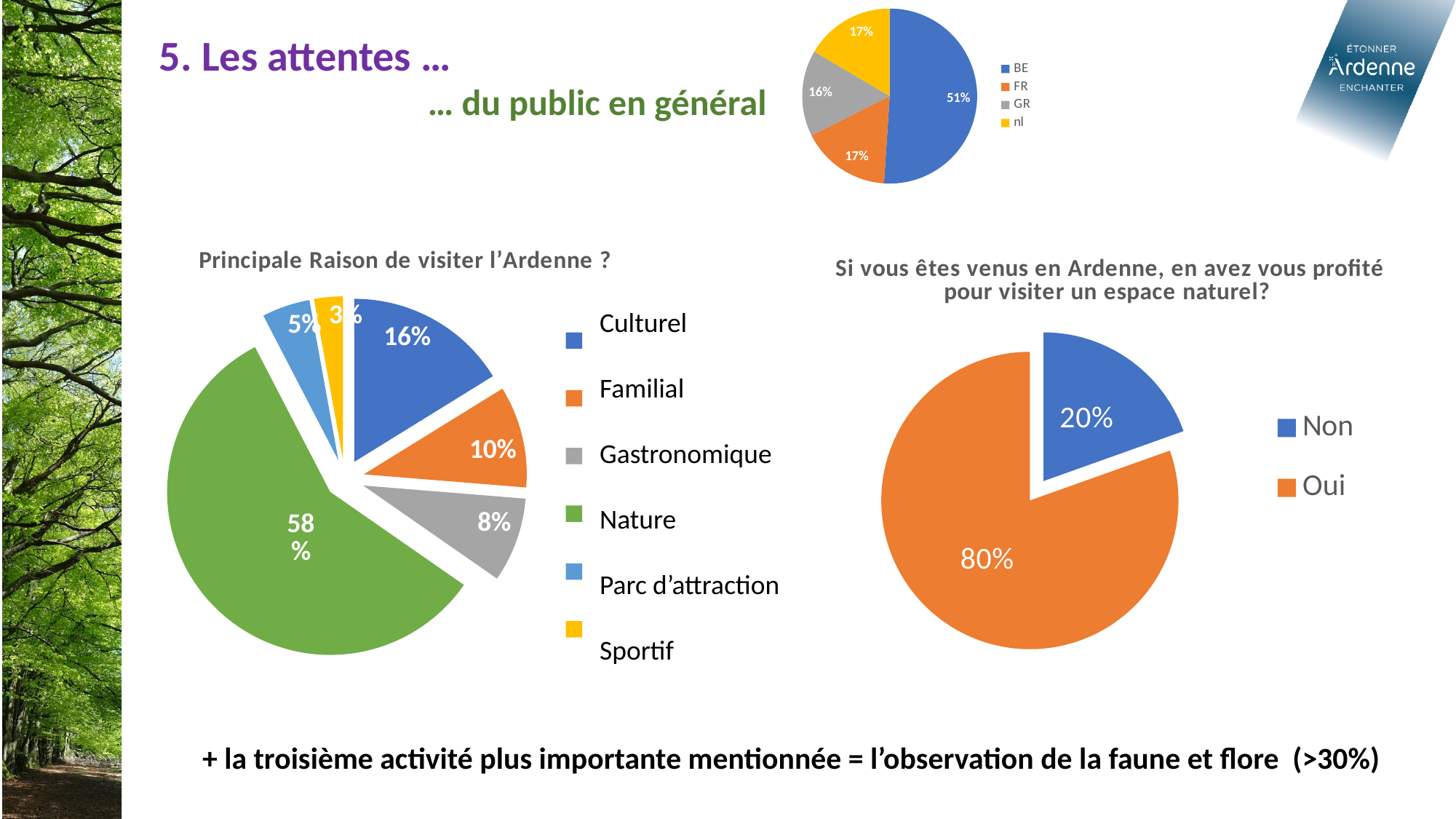
In the pie chart titled "Principale Raison de visiter l'Ardenne ?", which category has the largest slice? Nature How many categories does the legend of the small pie chart at the top of the slide list? 4 In the small pie chart at the top of the slide, what share is labelled for BE? 51% In the pie chart titled "Principale Raison de visiter l'Ardenne ?", what is the difference in percentage points between Familial and Gastronomique? 2 How many categories does the legend of the pie chart titled "Principale Raison de visiter l'Ardenne ?" list? 6 In the small pie chart at the top of the slide, what share is labelled for GR? 16% In the pie chart titled "Principale Raison de visiter l'Ardenne ?", what share is labelled for Nature? 58% In the pie chart titled "Principale Raison de visiter l'Ardenne ?", what share is labelled for Culturel? 16% In the pie chart titled "Si vous êtes venus en Ardenne, en avez vous profité pour visiter un espace naturel?", what share is labelled for Oui? 80% In the pie chart titled "Si vous êtes venus en Ardenne, en avez vous profité pour visiter un espace naturel?", which is larger, Non or Oui? Oui In the pie chart titled "Principale Raison de visiter l'Ardenne ?", which category has the smallest slice? Sportif What type of chart is the chart titled "Principale Raison de visiter l'Ardenne ?"? Pie chart